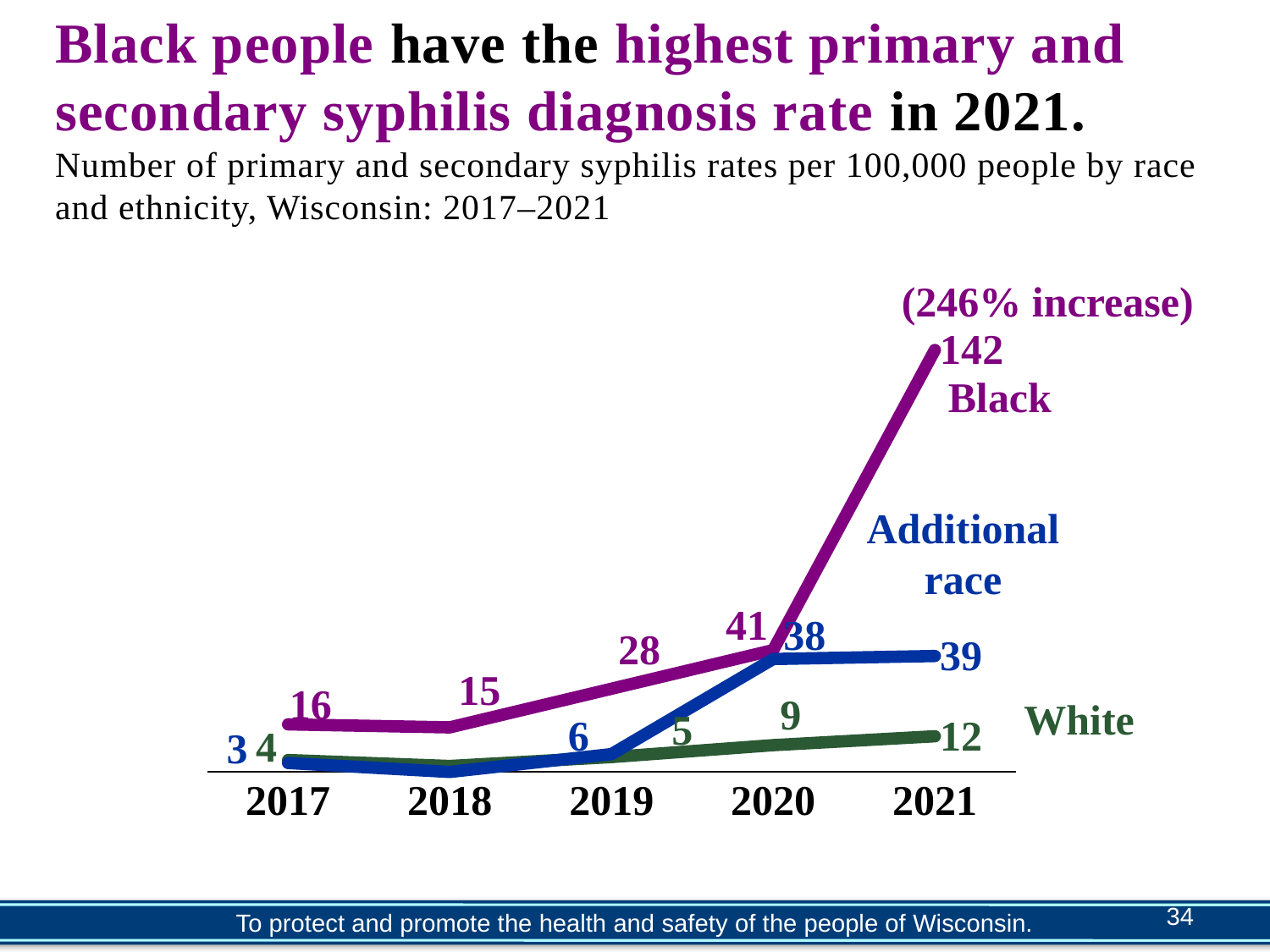
How many years are shown on the x axis? 5 What is the primary and secondary syphilis rate for Black people in 2021? 142 What is the rate for White people in 2021? 12 Which race/ethnicity group has the highest rate in 2021? Black What is the difference between the Black rate and the Additional race rate in 2021? 103 By how much did the rate for Black people increase from 2020 to 2021? 101 Which race/ethnicity group has the lowest rate in 2021? White What is the rate for Black people in 2017? 16 What type of chart is shown on the slide? Line chart How many race/ethnicity groups are plotted as lines? 3 In 2020, which is larger: the rate for Black people or the rate for the Additional race group? Black What is the rate for the Additional race group in 2020? 38